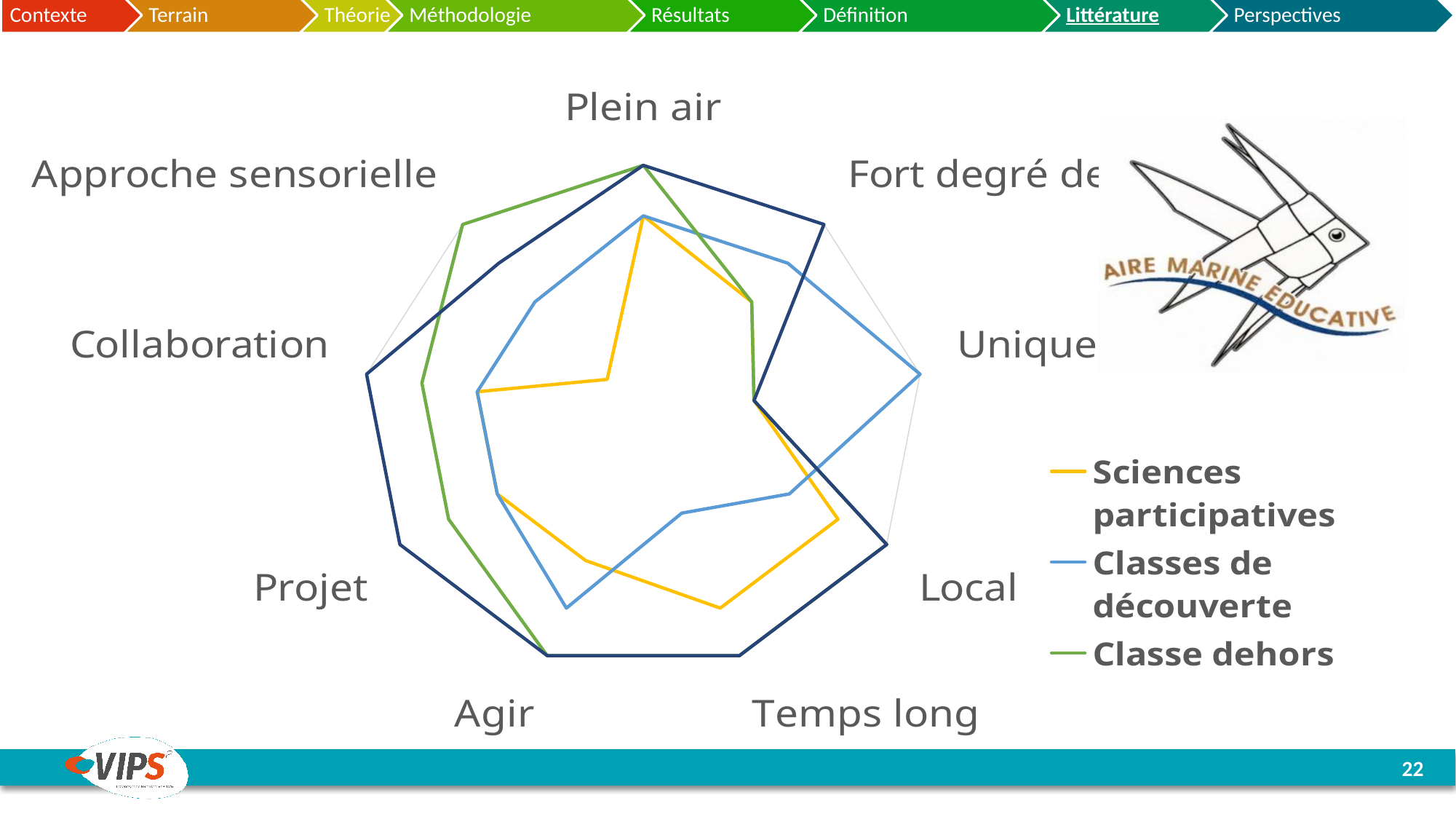
How many axes (categories) does the radar chart have? 9 On which axis does the Classes de découverte series have its highest value? Unique On the Agir axis, which series has the larger value: Classe dehors or Sciences participatives? Classe dehors On the Temps long axis, which series has the larger value: Sciences participatives or Classes de découverte? Sciences participatives On the Plein air axis, which series has the larger value: Classe dehors or Sciences participatives? Classe dehors How many series does the legend list? 3 Which series is shown in yellow in the legend? Sciences participatives On which axis does the Sciences participatives series have its lowest value? Approche sensorielle What kind of chart is shown on the slide? radar chart Which series is shown in green in the legend? Classe dehors